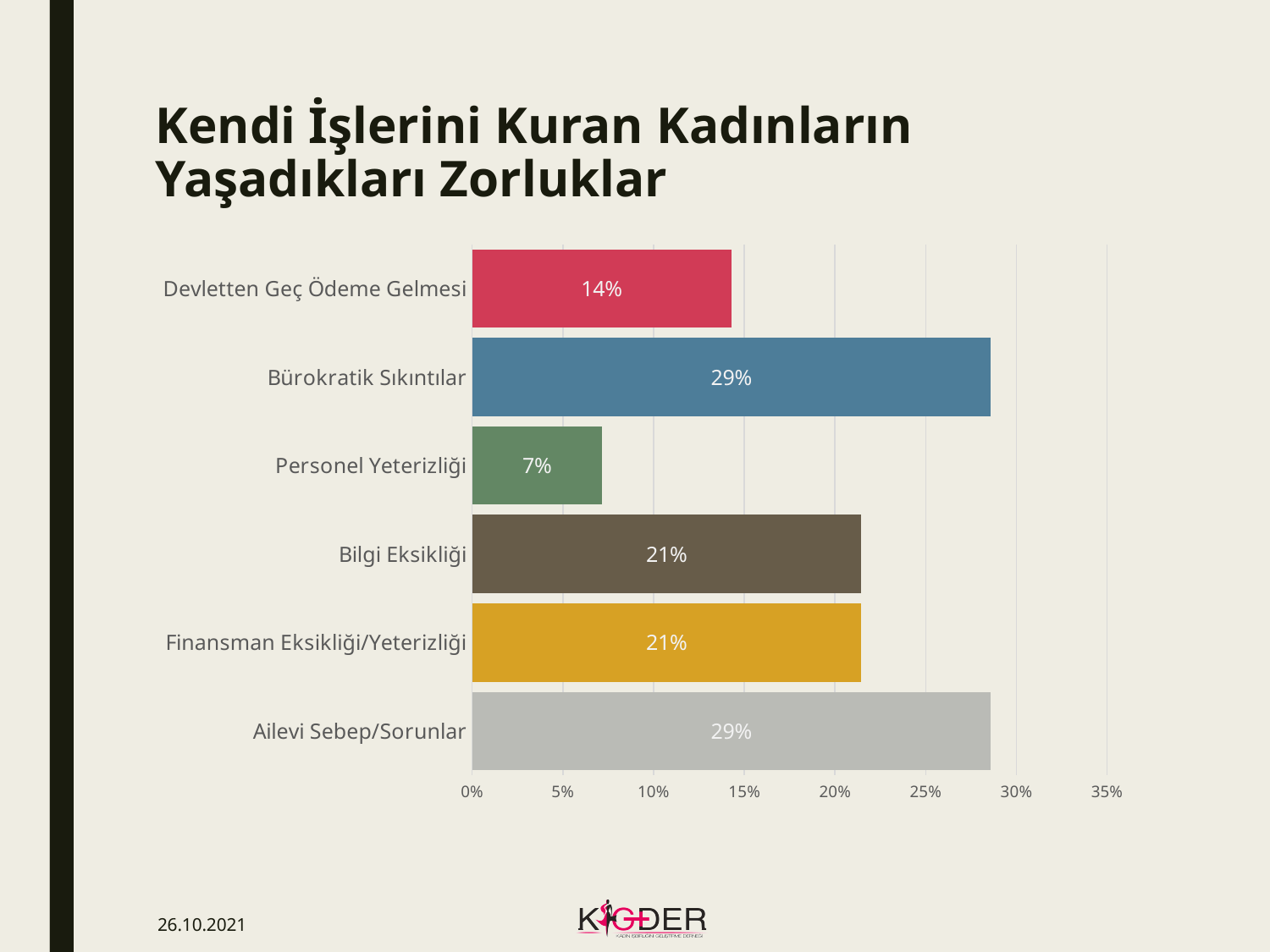
What is the difference between the values for Bilgi Eksikliği and Personel Yeterizliği? 14% What is the value for Devletten Geç Ödeme Gelmesi? 14% Which category has the lowest value? Personel Yeterizliği What kind of chart is shown on the slide? bar chart Is the value for Devletten Geç Ödeme Gelmesi greater or less than 10%? greater What is the difference between the values for Bürokratik Sıkıntılar and Devletten Geç Ödeme Gelmesi? 15% What is the value for Bürokratik Sıkıntılar? 29% What is the value for Bilgi Eksikliği? 21% What is the value for Personel Yeterizliği? 7% How many categories are shown in the chart? 6 What is the title of the chart on the slide? Kendi İşlerini Kuran Kadınların Yaşadıkları Zorluklar